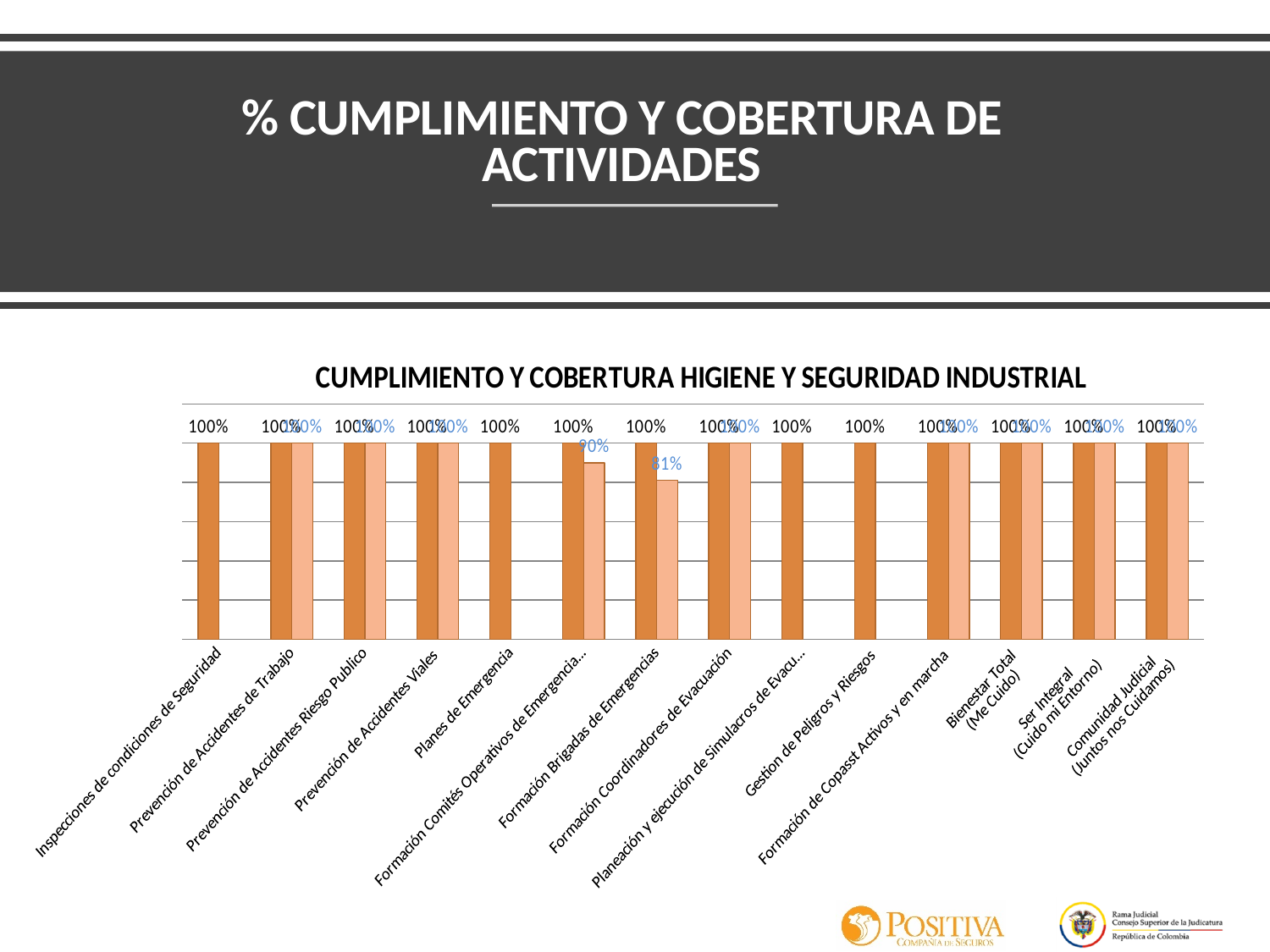
What is the value of the dark orange bar for Inspecciones de condiciones de Seguridad? 100% What value do all the dark orange bars in the chart show? 100% What is the difference between the lighter bar values for Formación Comités Operativos de Emergencia (90%) and Formación Brigadas de Emergencias (81%)? 9 percentage points What is the difference between the dark bar (100%) and the lighter bar (81%) for Formación Brigadas de Emergencias? 19 percentage points Which is larger: the lighter bar for Formación Comités Operativos de Emergencia or the lighter bar for Formación Brigadas de Emergencias? Formación Comités Operativos de Emergencia Which category has the lowest value among the lighter (second) bars? Formación Brigadas de Emergencias What is the value of the lighter (second) bar for Formación Comités Operativos de Emergencia? 90% How many categories are shown along the x axis of the chart? 14 What is the title of the chart? CUMPLIMIENTO Y COBERTURA HIGIENE Y SEGURIDAD INDUSTRIAL What is the value of the dark orange bar for Gestion de Peligros y Riesgos? 100% What kind of chart is shown on the slide? Bar chart What is the value of the lighter (second) bar for Formación Brigadas de Emergencias? 81%